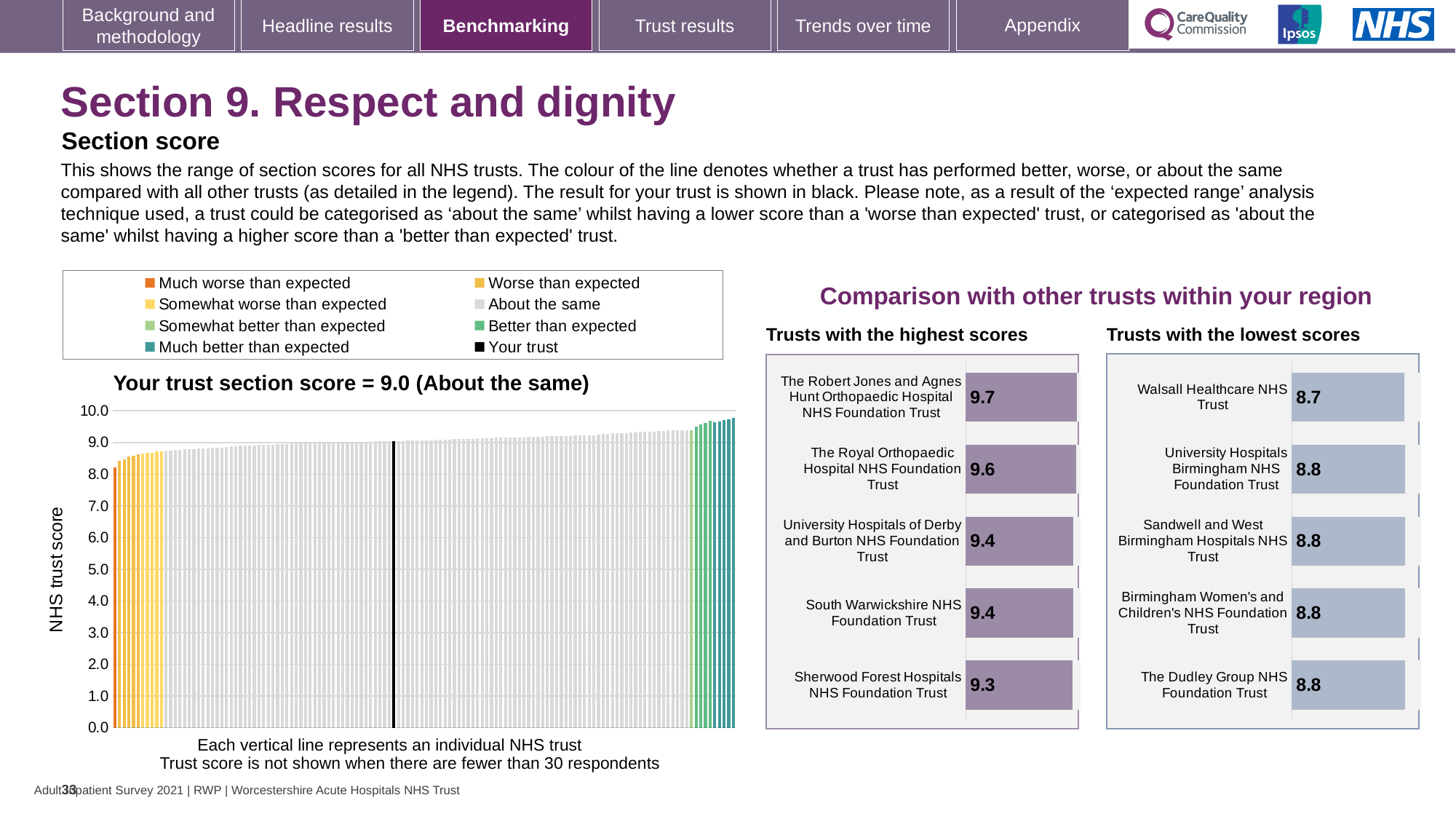
How many entries does the legend above the 'Your trust section score' chart list? 8 How many trusts are shown in the 'Trusts with the lowest scores' chart? 5 In the 'Your trust section score' chart, is the value of the leftmost (lowest) bar greater or less than 8.0? greater What is the y-axis label of the 'Your trust section score' chart? NHS trust score What kind of chart is the 'Your trust section score' chart? bar chart In the 'Your trust section score' chart, what is the section score for your trust? 9.0 In the 'Trusts with the lowest scores' chart, which trust has the lowest score? Walsall Healthcare NHS Trust In the 'Trusts with the highest scores' chart, which trust has the highest score? The Robert Jones and Agnes Hunt Orthopaedic Hospital NHS Foundation Trust In the 'Your trust section score' chart, do the bars rise or fall from left to right along the x axis? rise In the 'Trusts with the highest scores' chart, what is the difference between the scores of The Robert Jones and Agnes Hunt Orthopaedic Hospital NHS Foundation Trust and Sherwood Forest Hospitals NHS Foundation Trust? 0.4 In the 'Trusts with the highest scores' chart, what is the score for The Royal Orthopaedic Hospital NHS Foundation Trust? 9.6 In the 'Your trust section score' chart, is the value of the rightmost (highest) bar greater or less than 10.0? less